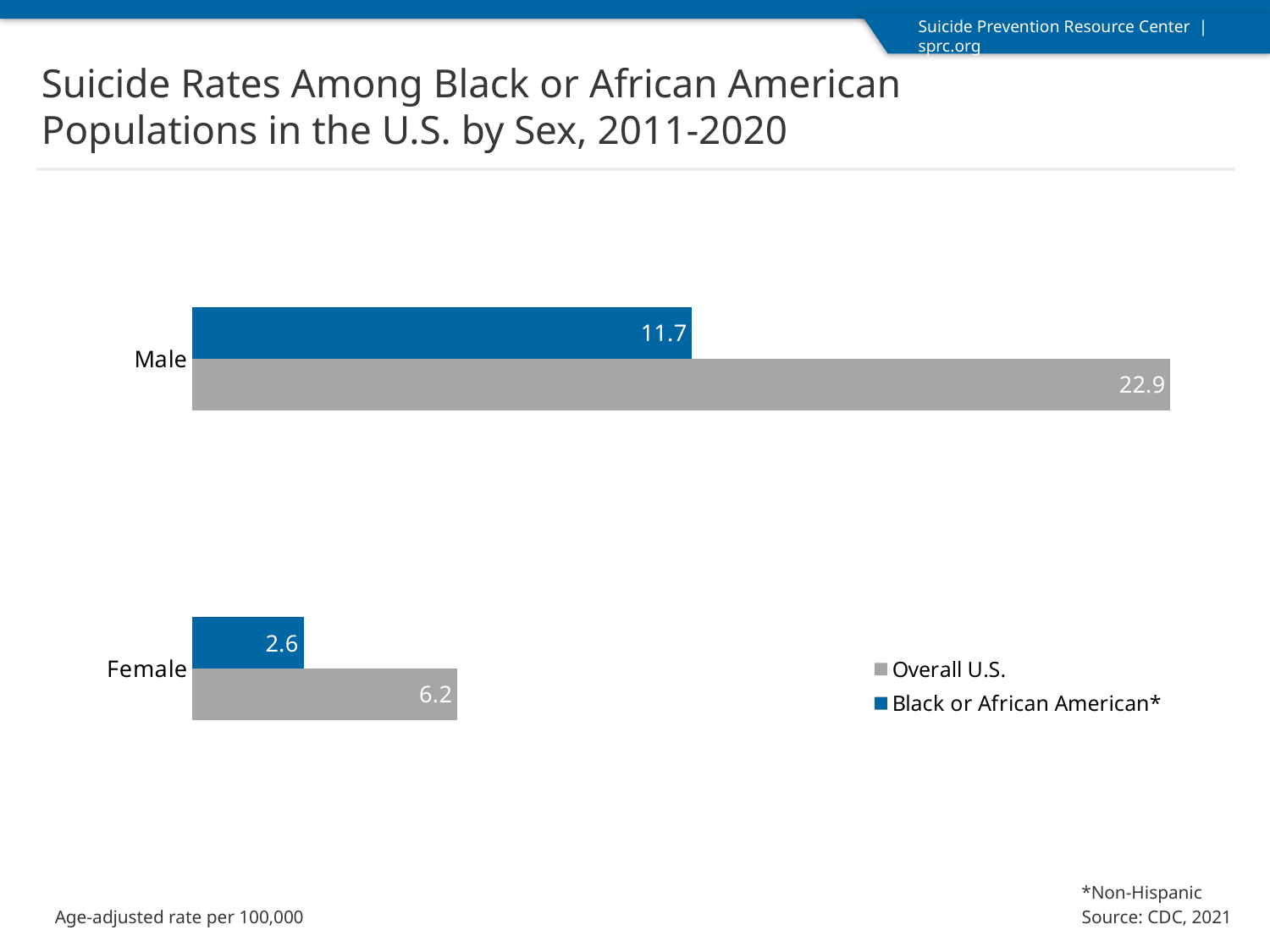
Which category has the lowest Black or African American suicide rate? Female What is the suicide rate for Black or African American females? 2.6 How many categories are shown on the chart? 2 What is the difference between the Overall U.S. rate and the Black or African American rate for males? 11.2 What is the difference between the Overall U.S. rate and the Black or African American rate for females? 3.6 Which category has the highest Overall U.S. suicide rate? Male How many series does the legend list? 2 What kind of chart is shown on the slide? Bar chart Which is larger for females: the Overall U.S. rate or the Black or African American rate? Overall U.S. What is the suicide rate for Black or African American males? 11.7 What is the Overall U.S. suicide rate for females? 6.2 What is the Overall U.S. suicide rate for males? 22.9